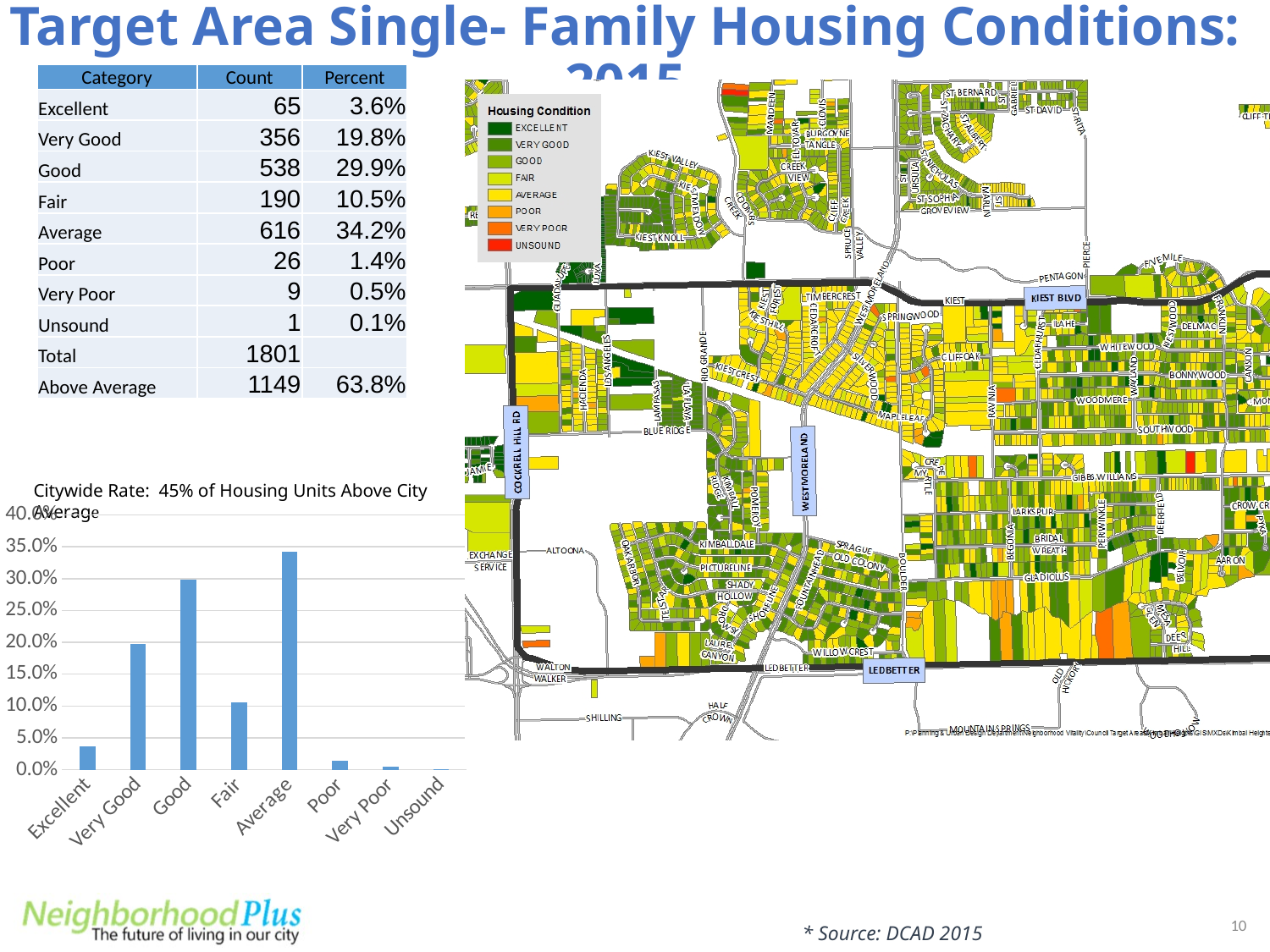
Is the value for Fair greater or less than 15.0%? less What type of chart is shown on the slide? bar chart What is the highest tick shown on the chart's vertical axis? 40.0% Is the value for Good greater or less than 25.0%? greater What is the difference between the Average value and the Good value? 4.3% How many categories are plotted on the bar chart? 8 Which category has the lowest value in the chart? Unsound Which category has the highest bar in the chart? Average What is the percent value for the Average category? 34.2% Which is larger, the value for Very Good or the value for Fair? Very Good What is the percent value for the Good category? 29.9% What is the percent value for the Excellent category? 3.6%